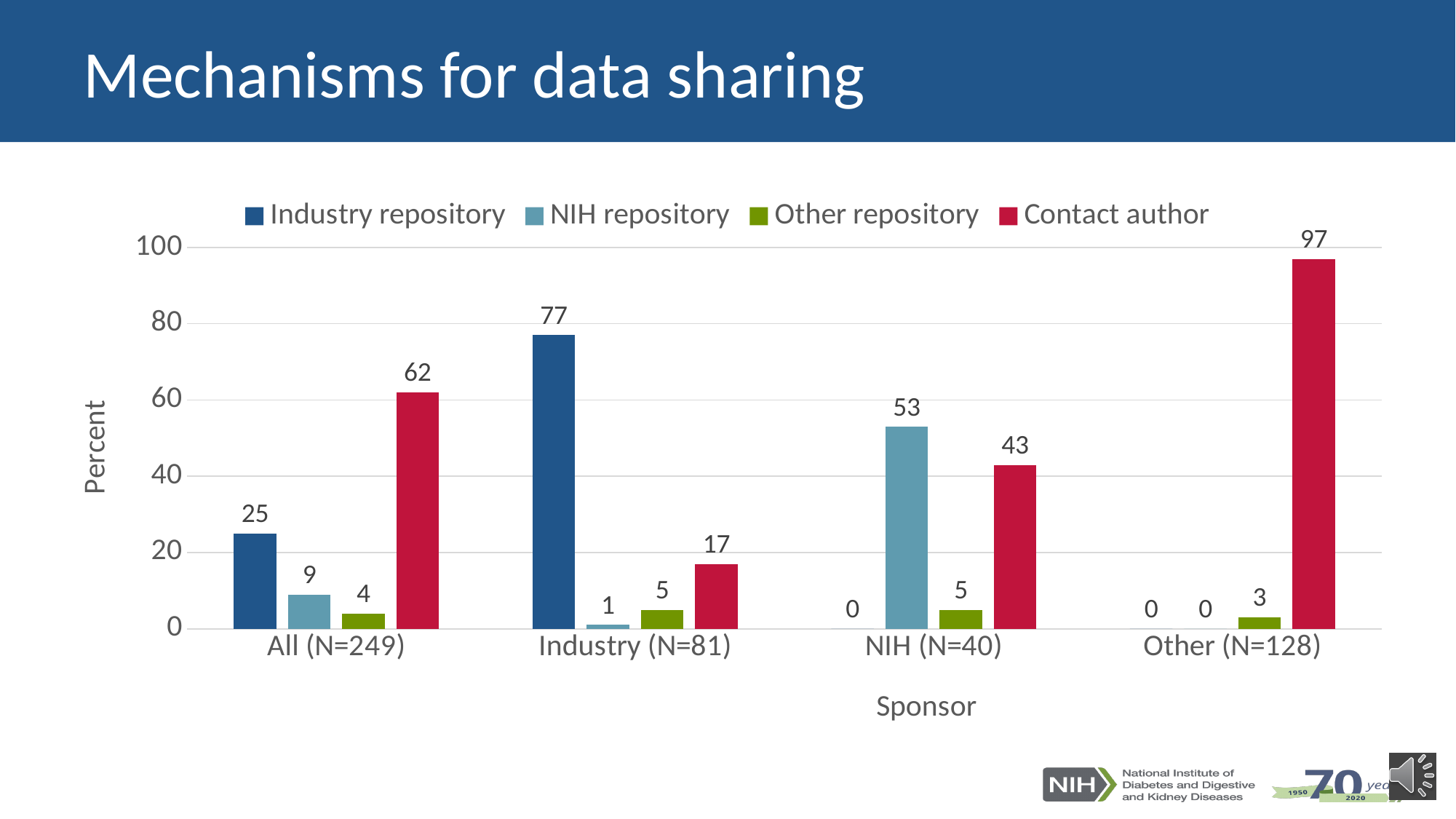
Which category has the highest Contact author value? Other (N=128) What is the label of the y axis? Percent What kind of chart is shown on the slide? Bar chart What is the value for NIH repository in the NIH (N=40) category? 53 What is the value for Other repository in the All (N=249) category? 4 What is the value for Industry repository in the Industry (N=81) category? 77 What is the value for Contact author in the Other (N=128) category? 97 Which is larger in the NIH (N=40) category: NIH repository or Contact author? NIH repository Which category has the lowest Industry repository value? NIH (N=40) and Other (N=128) (both 0) What is the difference between the Contact author values for Other (N=128) and All (N=249)? 35 How many series does the legend list? 4 How many sponsor categories are shown on the x axis? 4